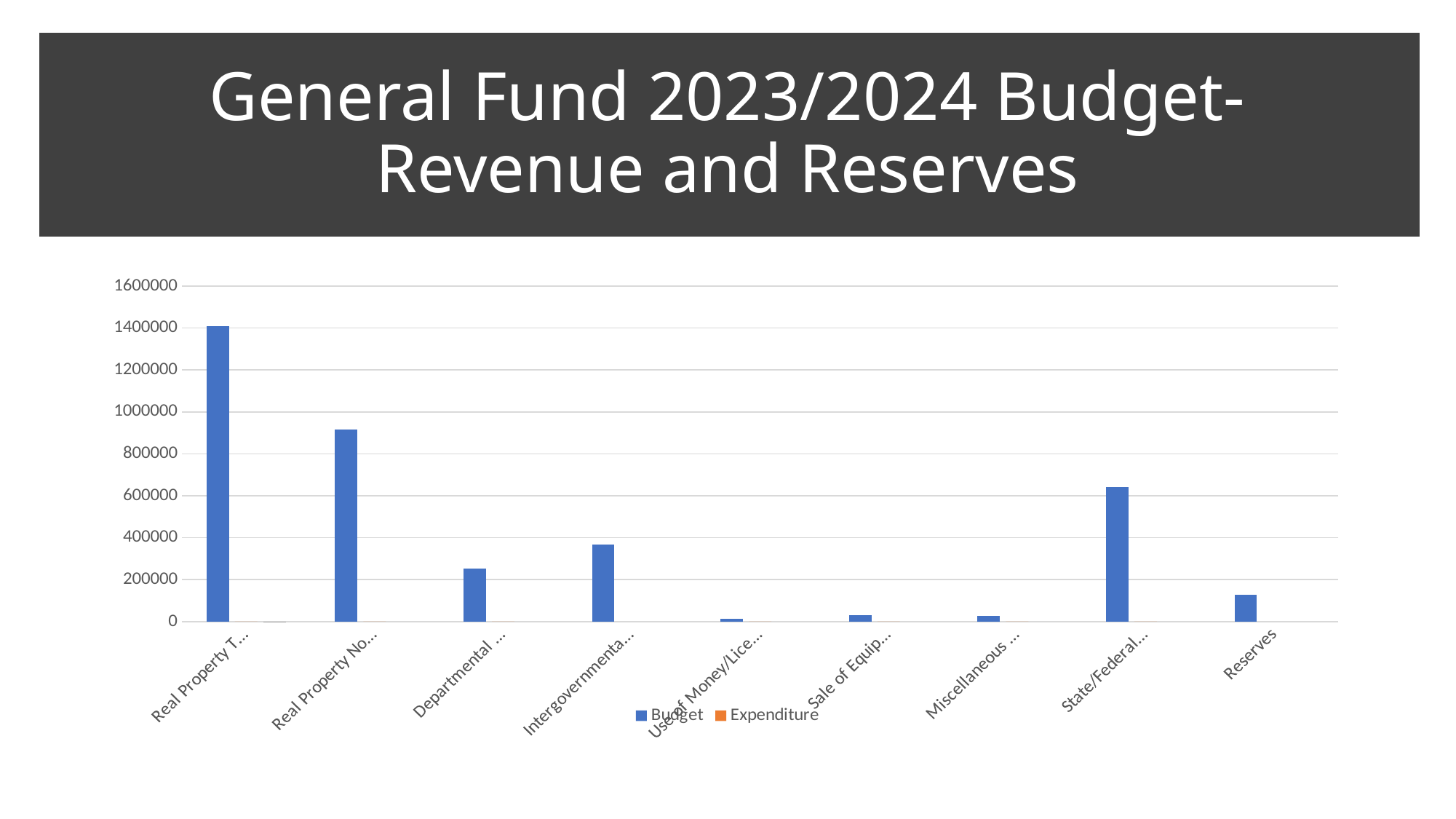
Is the Budget value for the second category (Real Property No...) greater or less than 800000? greater How many categories are shown along the x axis of the chart? 9 What is the title shown above the chart on the slide? General Fund 2023/2024 Budget- Revenue and Reserves What are the two series named in the chart's legend? Budget and Expenditure Which has the larger Budget bar: the second category (Real Property No...) or the State/Federal... category? Real Property No... Which has the larger Budget bar: Reserves or State/Federal...? State/Federal... What kind of chart is shown on the slide? Bar chart Is the Budget value for the State/Federal... category greater or less than 400000? greater Which category has the highest Budget bar? Real Property T... (the first category) Is the Budget value for the Departmental ... category greater or less than 400000? less How many series does the chart's legend list? 2